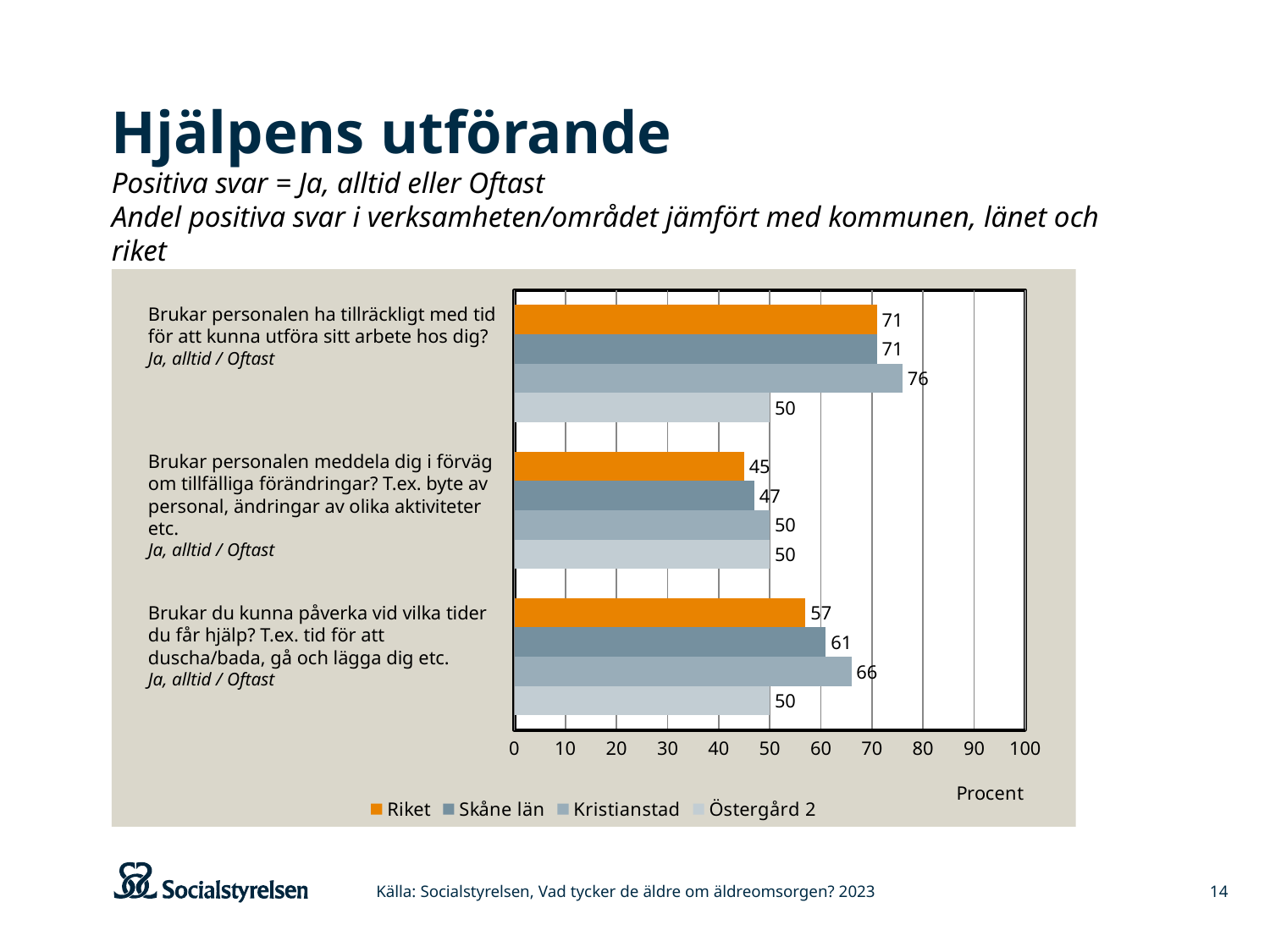
What is the difference between Kristianstad and Östergård 2 for the question "Brukar personalen ha tillräckligt med tid för att kunna utföra sitt arbete hos dig?"? 26 What kind of chart is shown on the slide? Bar chart Which is larger for the question "Brukar du kunna påverka vid vilka tider du får hjälp?": Riket or Skåne län? Skåne län What is the value for Skåne län for the question "Brukar du kunna påverka vid vilka tider du får hjälp?"? 61 What is the value for Riket for the question "Brukar personalen meddela dig i förväg om tillfälliga förändringar?"? 45 Which series has the lowest value for the question "Brukar personalen ha tillräckligt med tid för att kunna utföra sitt arbete hos dig?"? Östergård 2 What is the value for Kristianstad for the question "Brukar personalen ha tillräckligt med tid för att kunna utföra sitt arbete hos dig?"? 76 Is the value for Riket for the question "Brukar personalen meddela dig i förväg om tillfälliga förändringar?" greater or less than 50? less How many question categories are plotted on the chart? 3 How many series does the legend list? 4 Which series has the highest value for the question "Brukar du kunna påverka vid vilka tider du får hjälp?"? Kristianstad What unit label is shown below the x axis of the chart? Procent